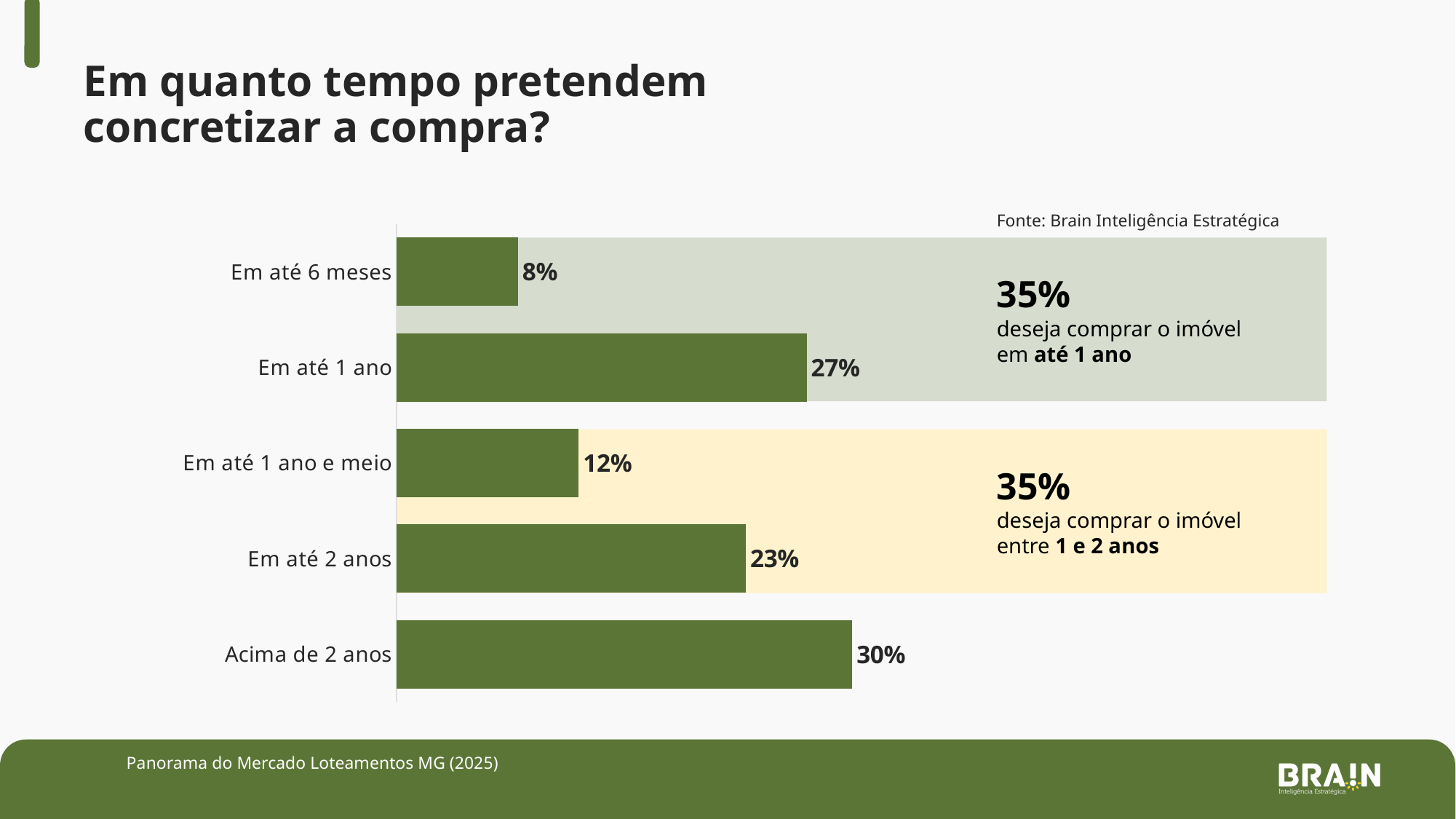
How many categories does the chart show? 5 Which is larger, the value for "Em até 1 ano e meio" or the value for "Em até 6 meses"? Em até 1 ano e meio What is the value for "Acima de 2 anos"? 30% What is the value for "Em até 1 ano e meio"? 12% Which category has the lowest value? Em até 6 meses What is the difference between the values for "Em até 1 ano" and "Em até 2 anos"? 4% What is the value for "Em até 1 ano"? 27% What is the combined value of "Em até 6 meses" and "Em até 1 ano"? 35% What is the value for "Em até 6 meses"? 8% What kind of chart is shown on the slide? Bar chart What is the value for "Em até 2 anos"? 23% Which category has the highest value? Acima de 2 anos